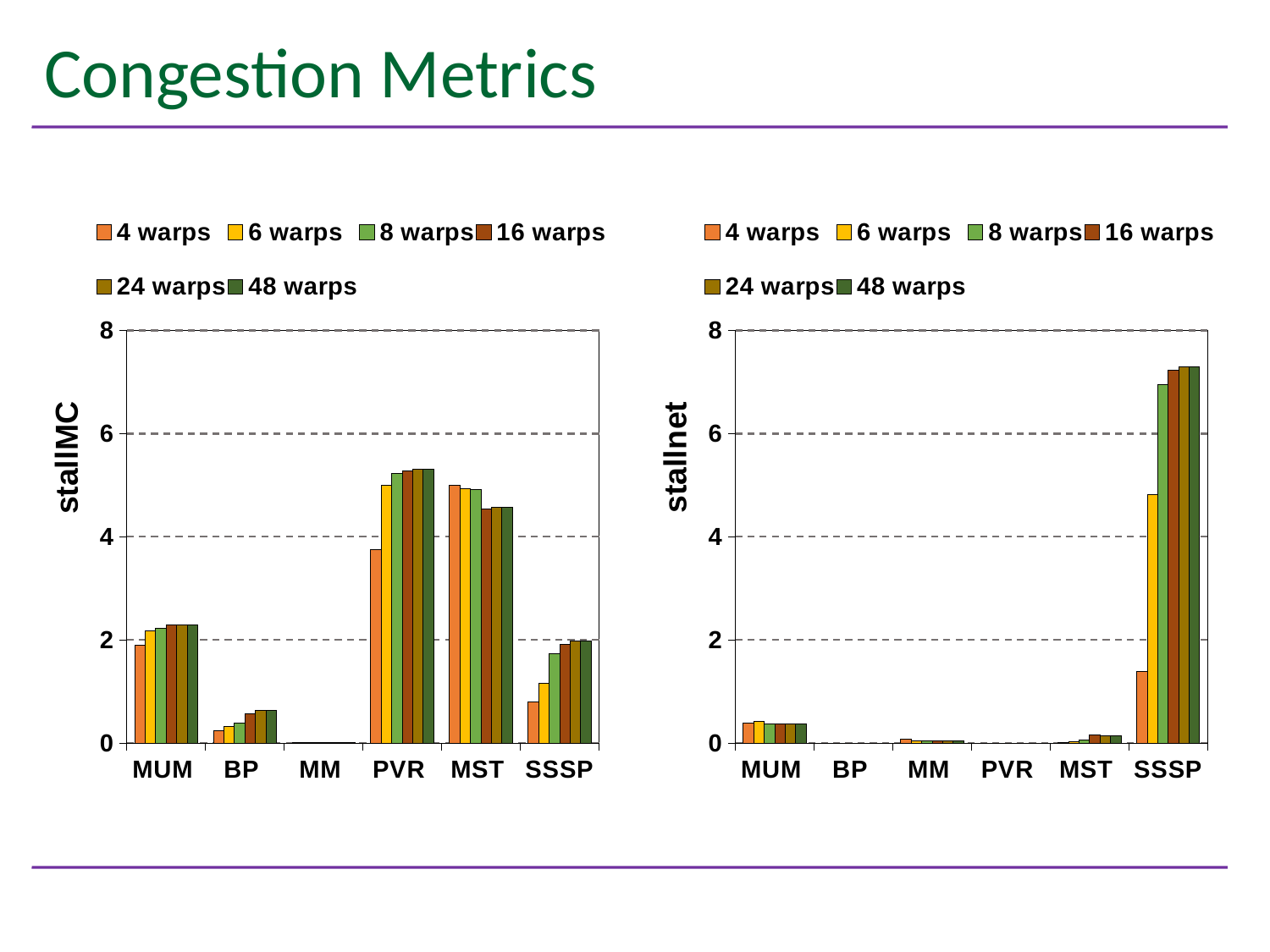
In the stallnet chart, is the value for SSSP with 4 warps greater or less than 2? less How many categories are shown on the x axis of the stallMC chart? 6 In the stallnet chart, which category has the highest value for 48 warps? SSSP What kind of chart is the stallMC chart on the left? bar chart In the stallMC chart, is the value for PVR with 4 warps greater or less than 4? less In the stallnet chart, is the value for SSSP with 48 warps greater or less than 6? greater What is the y-axis label of the chart on the right? stallnet How many series does the legend of the stallnet chart list? 6 In the stallMC chart, which category has the lowest values across all series? MM In the stallMC chart, which category has the highest value for 48 warps? PVR In the stallMC chart, which is larger for 4 warps: MST or PVR? MST In the stallMC chart, do the SSSP values rise or fall as the number of warps increases? rise